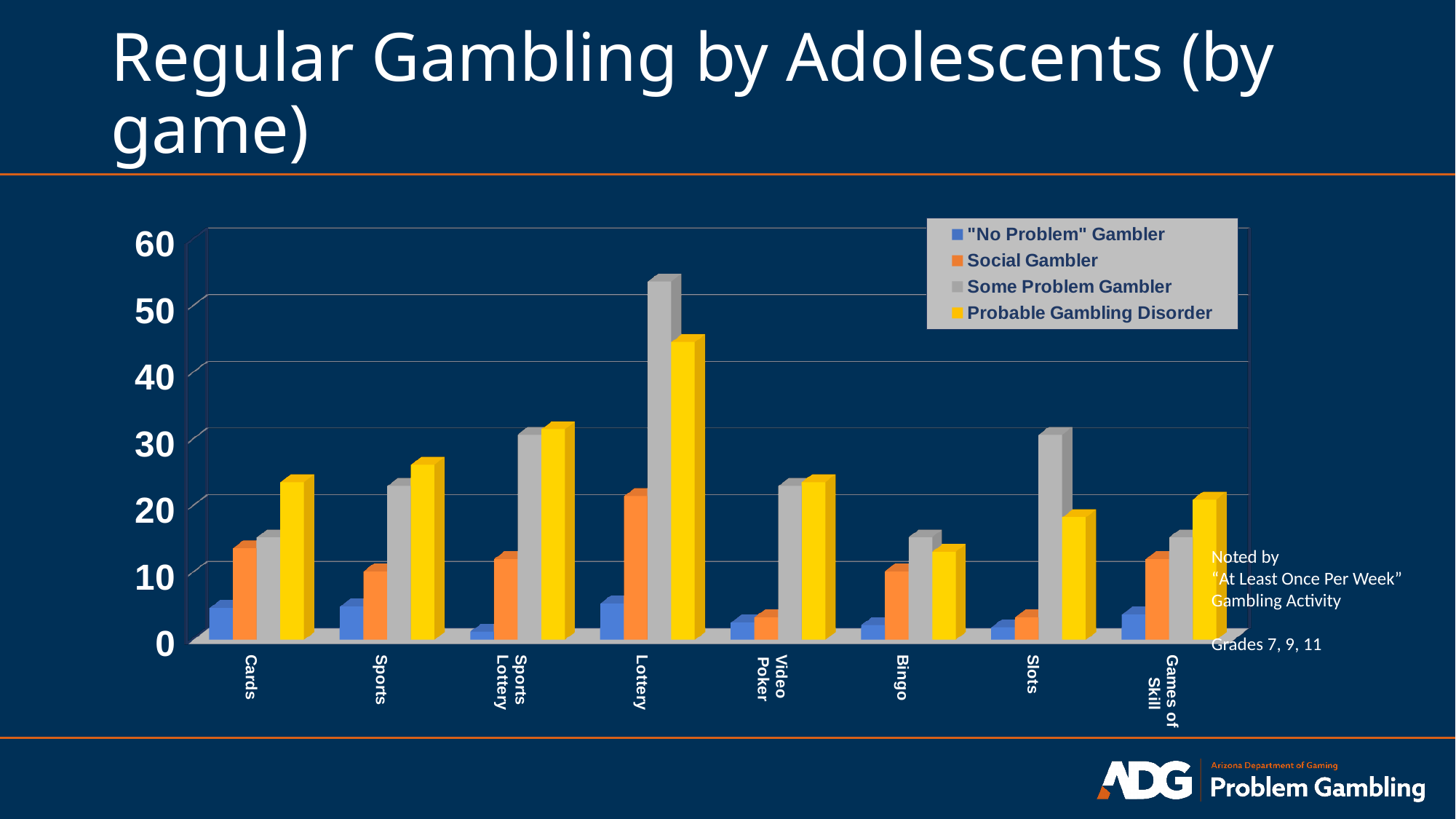
Which game has the highest value for the Probable Gambling Disorder series? Lottery Is the "No Problem" Gambler value for Video Poker greater or less than 10? less Which game has the lowest value for the Probable Gambling Disorder series? Bingo What is the title of the slide containing the chart? Regular Gambling by Adolescents (by game) For Cards, which is larger: the Social Gambler value or the "No Problem" Gambler value? Social Gambler Which game has the highest value for the Some Problem Gambler series? Lottery How many series does the legend list? 4 For Lottery, which is larger: the Some Problem Gambler value or the Probable Gambling Disorder value? Some Problem Gambler What kind of chart is shown on the slide? Bar chart Is the Probable Gambling Disorder value for Lottery greater or less than 40? greater Is the Some Problem Gambler value for Lottery greater or less than 50? greater How many game categories are shown on the x axis? 8